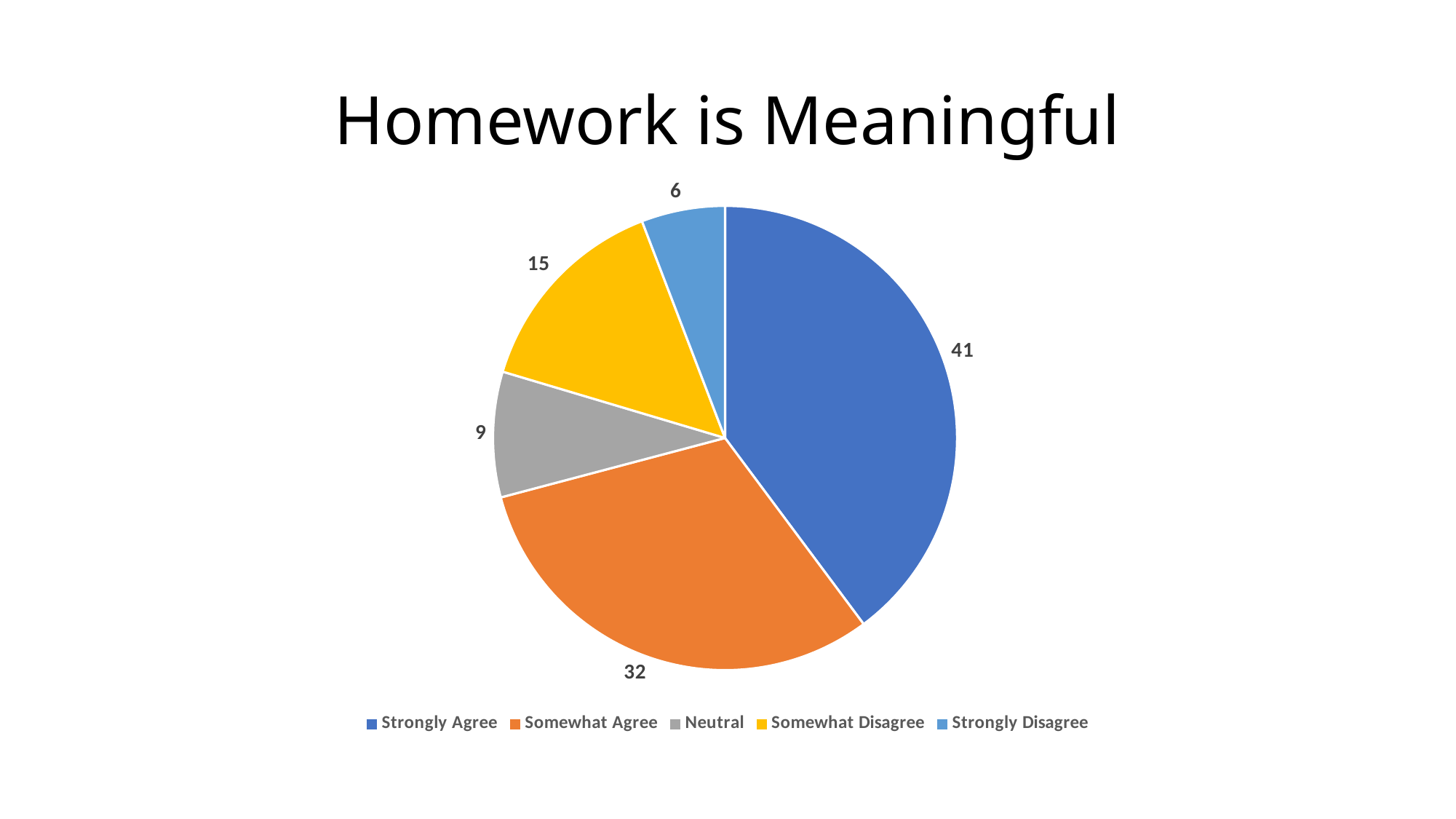
What is the title of the chart? Homework is Meaningful Which is larger, the Somewhat Disagree slice or the Neutral slice? Somewhat Disagree How many categories does the pie chart show? 5 Which category has the largest slice of the pie? Strongly Agree Which category has the smallest slice of the pie? Strongly Disagree What value is shown for the Neutral slice? 9 What is the difference between the Strongly Agree and Somewhat Agree values? 9 What value is shown for the Strongly Agree slice? 41 What value is shown for the Strongly Disagree slice? 6 What value is shown for the Somewhat Agree slice? 32 What kind of chart is shown on the slide? Pie chart What value is shown for the Somewhat Disagree slice? 15